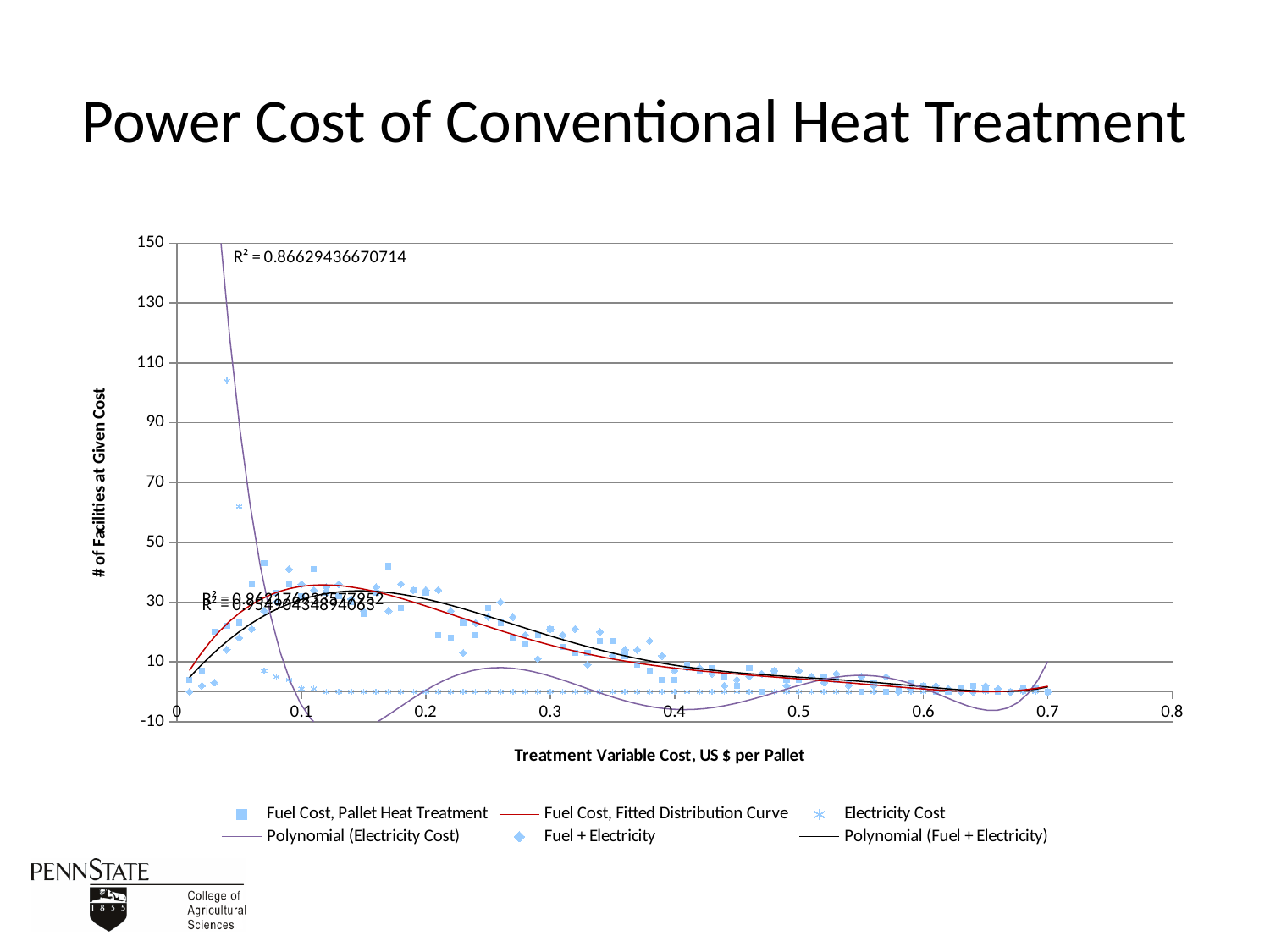
What is the title of the chart? Power Cost of Conventional Heat Treatment What is the maximum value shown on the x axis? 0.8 What kind of chart is shown on the slide? Scatter chart What is the maximum value shown on the y axis? 150 What R² value is printed near the top left of the plot area? R² = 0.86629436670714 How many series does the legend list? 6 What is the x-axis title of the chart? Treatment Variable Cost, US $ per Pallet Do the Fuel Cost, Pallet Heat Treatment values generally rise or fall as the x axis goes from 0.2 to 0.7? fall Is the highest Electricity Cost point (near x = 0.04) greater or less than 110? less Is the highest Electricity Cost point (near x = 0.04) greater or less than 90? greater Is the value of the Fuel Cost, Fitted Distribution Curve at x = 0.6 greater or less than 10? less